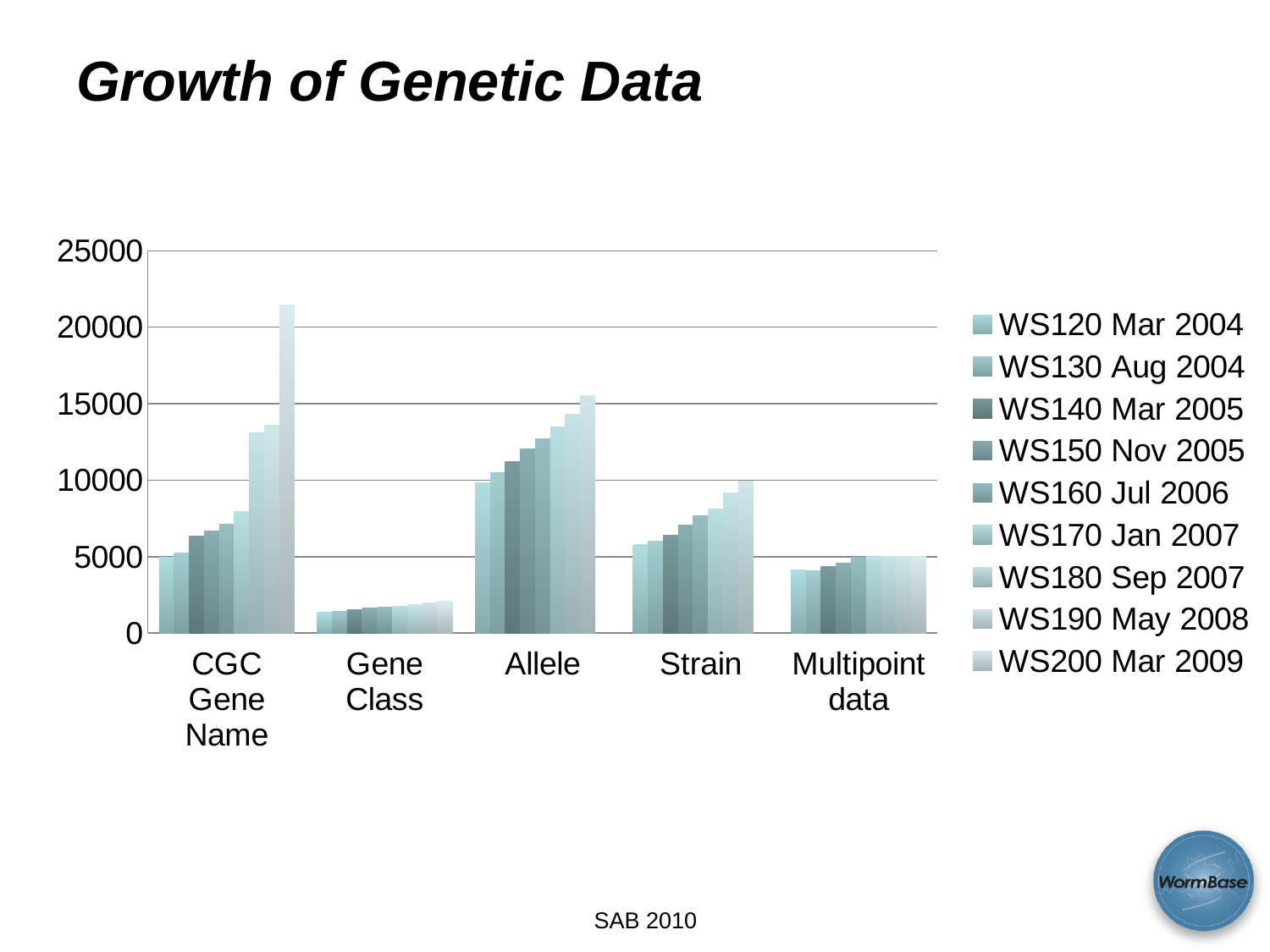
What is the title of the slide containing the chart? Growth of Genetic Data What kind of chart is shown on the slide? bar chart Is the value for Gene Class in WS200 Mar 2009 greater or less than 5000? less Within the CGC Gene Name category, which release has the highest value? WS200 Mar 2009 How many categories are shown on the x axis? 5 Which category has the tallest bar in the chart? CGC Gene Name Which category has the lowest values across all releases? Gene Class Do the Allele values rise or fall from WS120 Mar 2004 to WS200 Mar 2009? rise How many series does the legend list? 9 Is the value for CGC Gene Name in WS200 Mar 2009 greater or less than 20000? greater Which is larger for WS120 Mar 2004: Allele or Strain? Allele